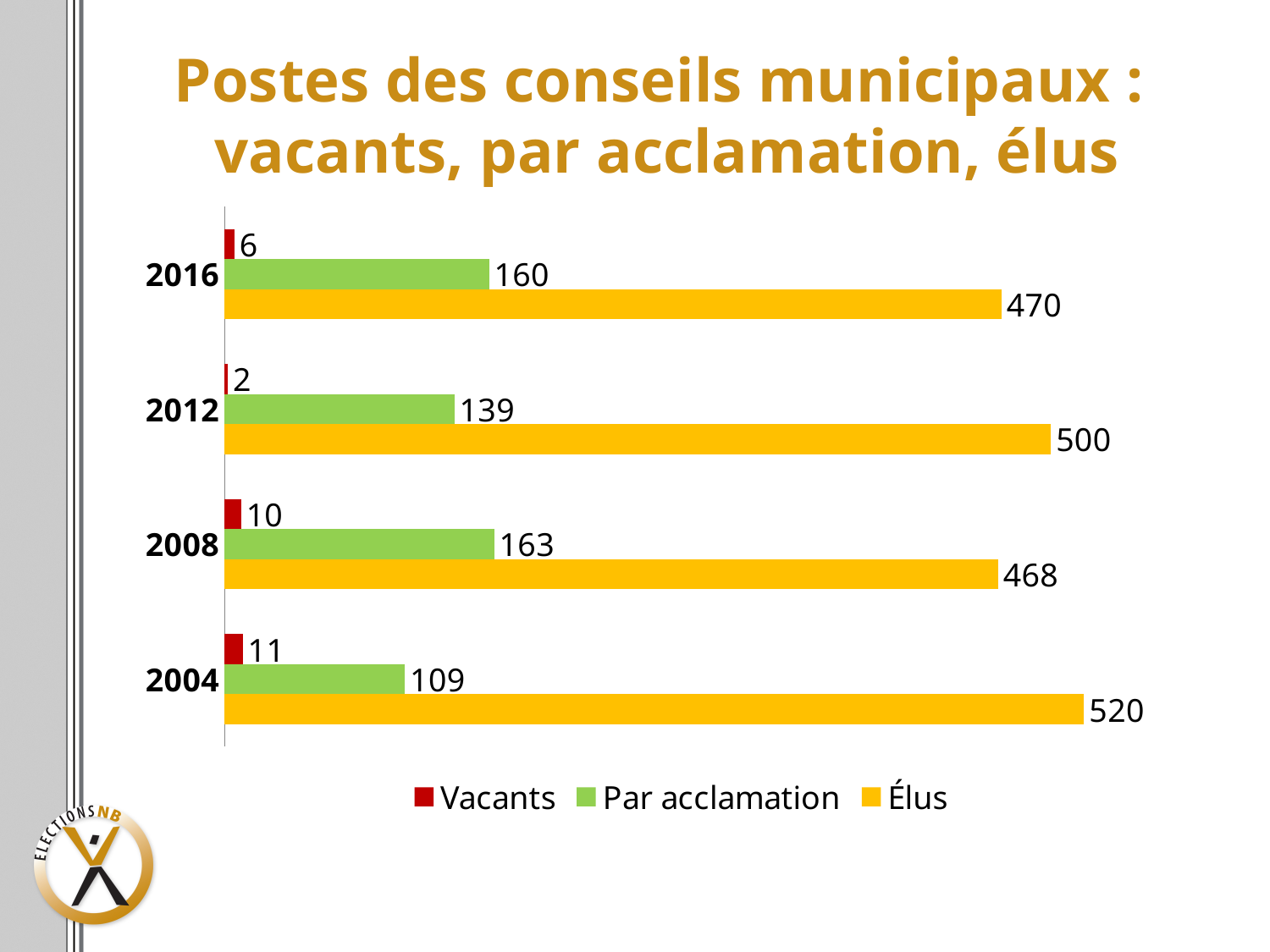
How many series does the legend list? 3 What is the value for Vacants in 2008? 10 How many years are shown on the chart? 4 What is the total of Vacants, Par acclamation and Élus for 2016? 636 Which colour represents the Vacants series in the legend? red Which year has the lowest value for Vacants? 2012 What kind of chart is shown on the slide? bar chart Which year has the highest value for Élus? 2004 What is the difference between the Élus values for 2012 and 2016? 30 What is the value for Élus in 2012? 500 What is the value for Par acclamation in 2004? 109 Which is larger: Par acclamation in 2008 or Par acclamation in 2016? 2008